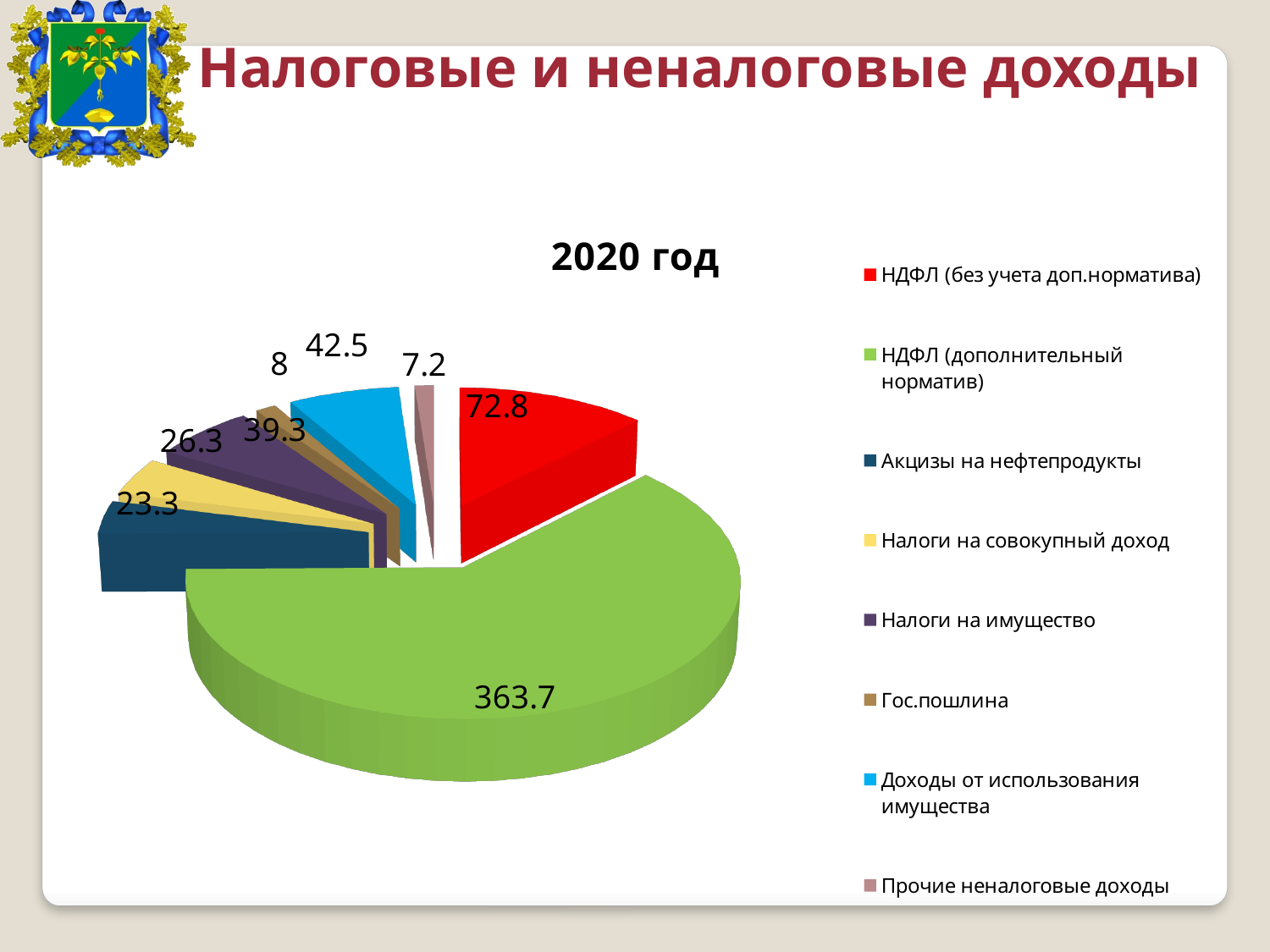
What is the value for НДФЛ (дополнительный норматив)? 363.7 Which is larger: Налоги на имущество or Налоги на совокупный доход? Налоги на имущество What is the value for Доходы от использования имущества? 42.5 What is the difference between НДФЛ (без учета доп.норматива) and Доходы от использования имущества? 30.3 How many categories does the legend list? 8 Which category has the largest slice? НДФЛ (дополнительный норматив) What is the value for НДФЛ (без учета доп.норматива)? 72.8 What is the value for Прочие неналоговые доходы? 7.2 Which category has the smallest slice? Прочие неналоговые доходы What type of chart is shown on the slide? Pie chart What is the title of the chart? 2020 год What is the value for Гос.пошлина? 8